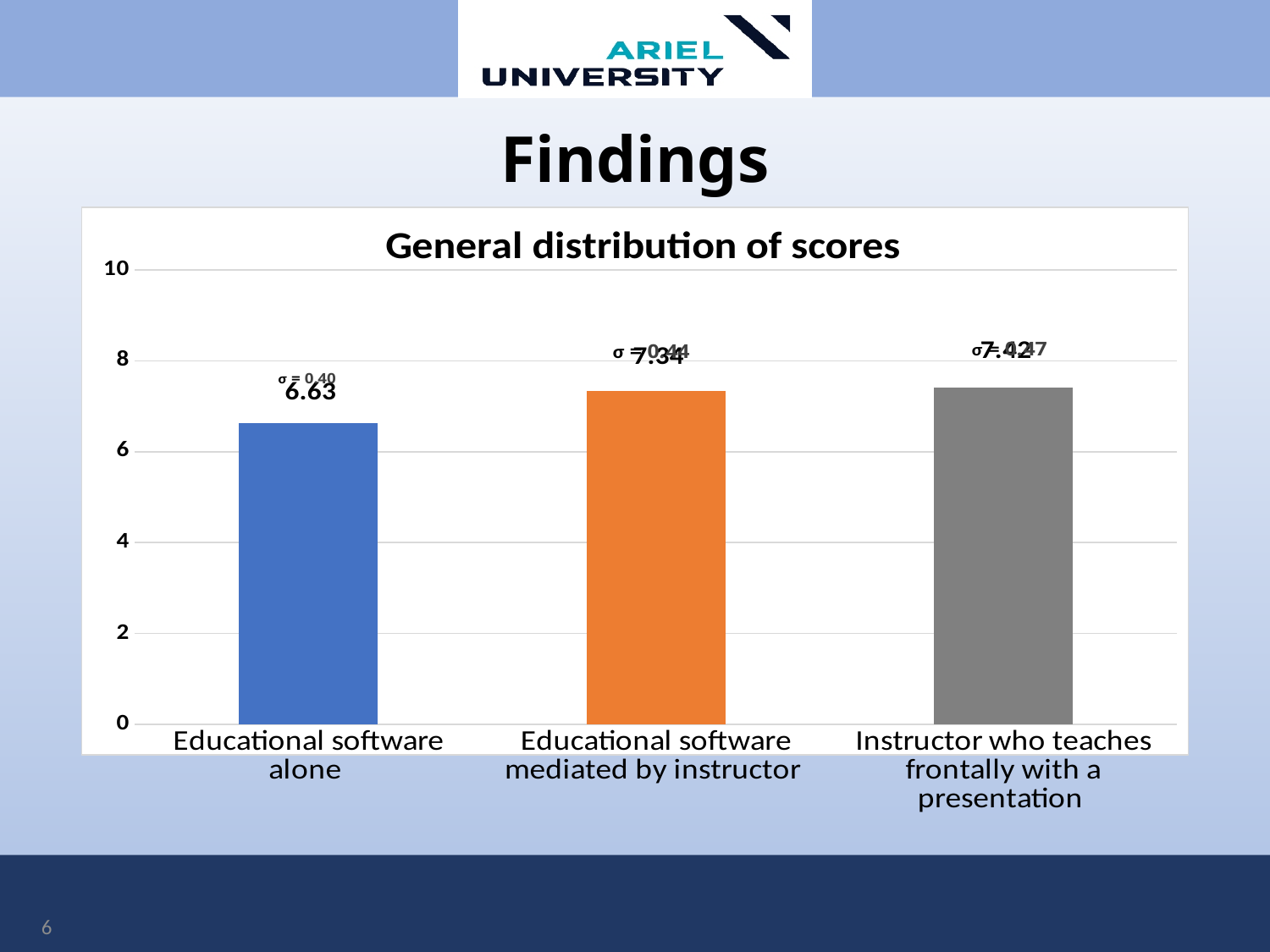
What is the title of the chart? General distribution of scores What is the difference between the scores for 'Educational software mediated by instructor' and 'Educational software alone'? 0.71 What is the difference between the scores for 'Instructor who teaches frontally with a presentation' and 'Educational software alone'? 0.79 What is the score for 'Educational software mediated by instructor'? 7.34 What is the score for 'Instructor who teaches frontally with a presentation'? 7.42 What type of chart is shown on the slide? Bar chart Is the value for 'Educational software alone' greater or less than 8? less What is the score for 'Educational software alone'? 6.63 Which category has the highest score? Instructor who teaches frontally with a presentation Which is larger: the score for 'Educational software alone' or for 'Educational software mediated by instructor'? Educational software mediated by instructor How many categories are shown in the chart? 3 Which category has the lowest score? Educational software alone